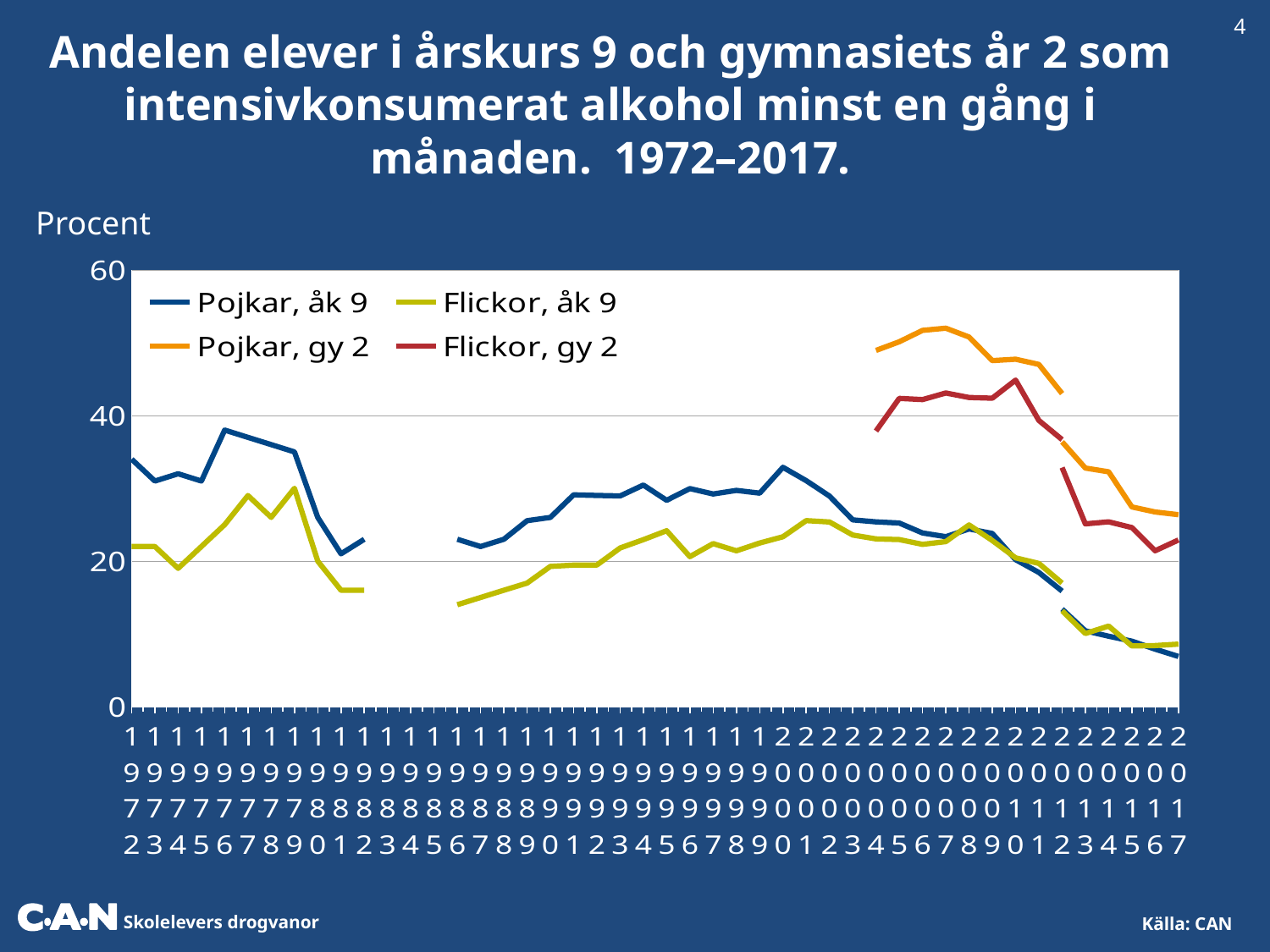
In 1976, which is larger: Pojkar, åk 9 or Flickor, åk 9? Pojkar, åk 9 Is the value for Flickor, gy 2 in 2017 greater or less than 20? greater Is the value for Flickor, åk 9 in 1989 greater or less than 20? less Is the value for Pojkar, åk 9 in 2017 greater or less than 20? less Which series are listed in the legend? Pojkar, åk 9; Flickor, åk 9; Pojkar, gy 2; Flickor, gy 2 In 2007, which is larger: Pojkar, gy 2 or Flickor, gy 2? Pojkar, gy 2 Which series reaches the highest value on the chart? Pojkar, gy 2 What unit is shown on the y axis label above the chart? Procent How many series does the legend list? 4 Does the Pojkar, gy 2 series rise or fall from 2007 to 2017? fall What kind of chart is shown on the slide? line chart